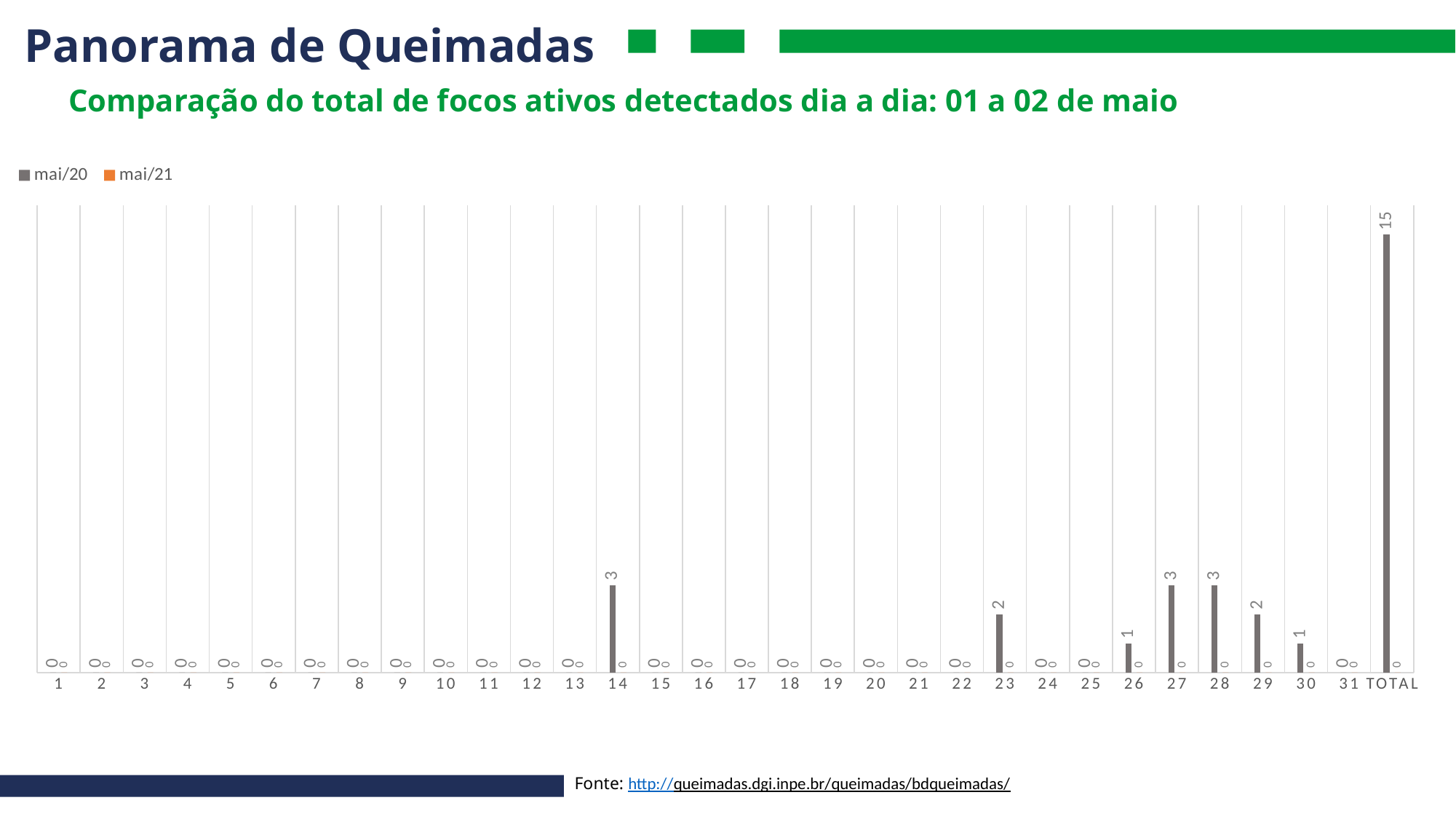
What are the two series names in the legend? mai/20 and mai/21 What is the mai/21 value for day 27? 0 Which category has the highest mai/20 value? TOTAL What is the difference between the mai/20 values for day 27 and day 29? 1 Which is larger, the mai/20 value for day 28 or for day 30? day 28 What is the mai/20 value for day 23? 2 How many categories are shown on the x axis, including TOTAL? 32 What is the mai/20 value for day 14? 3 How many series does the legend list? 2 What is the mai/20 value for the TOTAL category? 15 What is the mai/20 value for day 26? 1 What type of chart is shown on the slide? bar chart